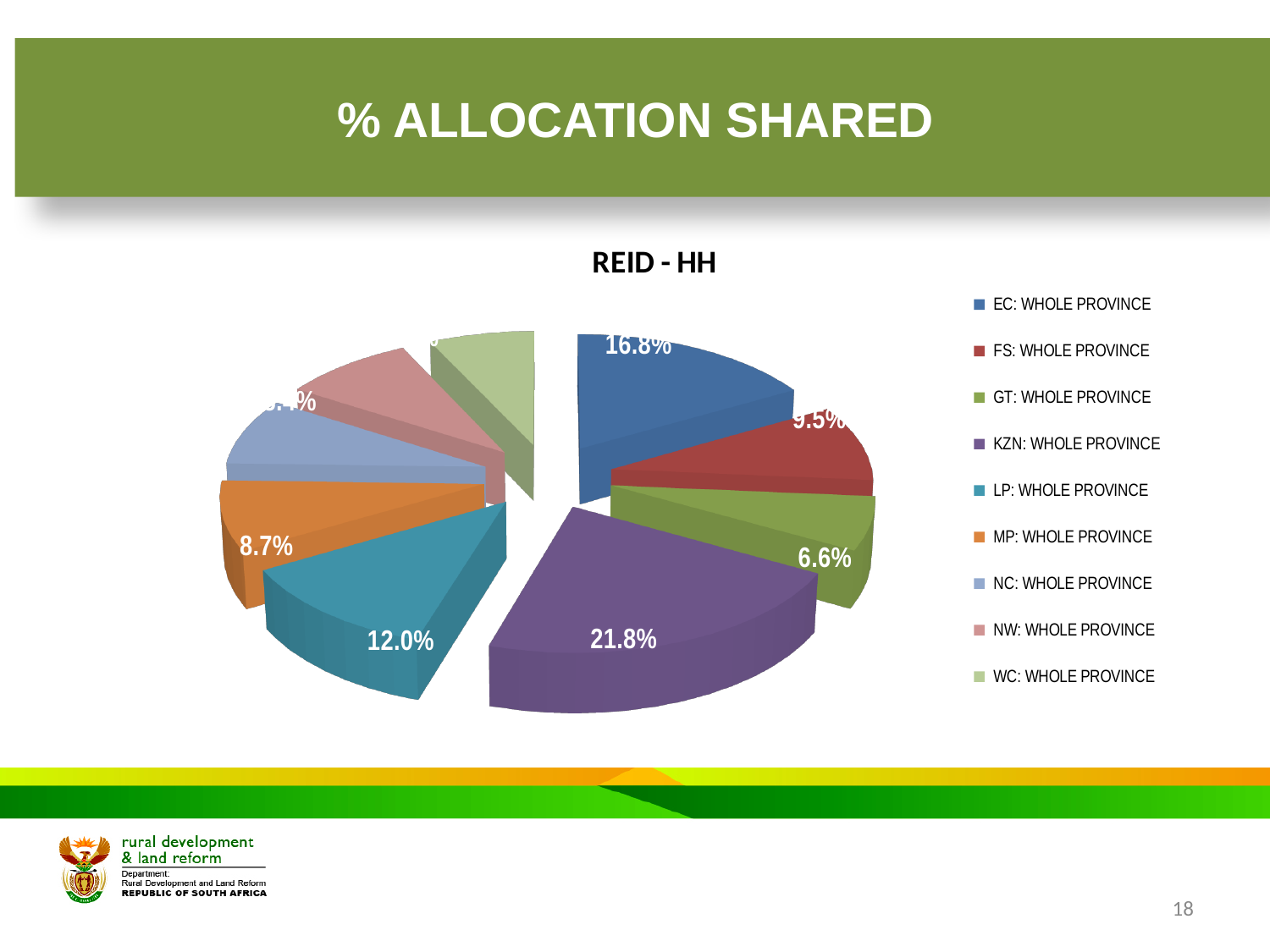
What percentage share is shown for MP: WHOLE PROVINCE? 8.7% What is the difference in percentage points between the KZN and EC shares? 5.0% What is the title of the chart? REID - HH What is the difference in percentage points between the LP and MP shares? 3.3% Which province has the largest share of the pie? KZN: WHOLE PROVINCE What percentage share is shown for GT: WHOLE PROVINCE? 6.6% What percentage share is shown for LP: WHOLE PROVINCE? 12.0% What percentage share is shown for EC: WHOLE PROVINCE? 16.8% Which has the larger share, KZN: WHOLE PROVINCE or EC: WHOLE PROVINCE? KZN: WHOLE PROVINCE What percentage share is shown for KZN: WHOLE PROVINCE? 21.8% How many provinces (categories) does the legend list? 9 What type of chart is shown on the slide? Pie chart